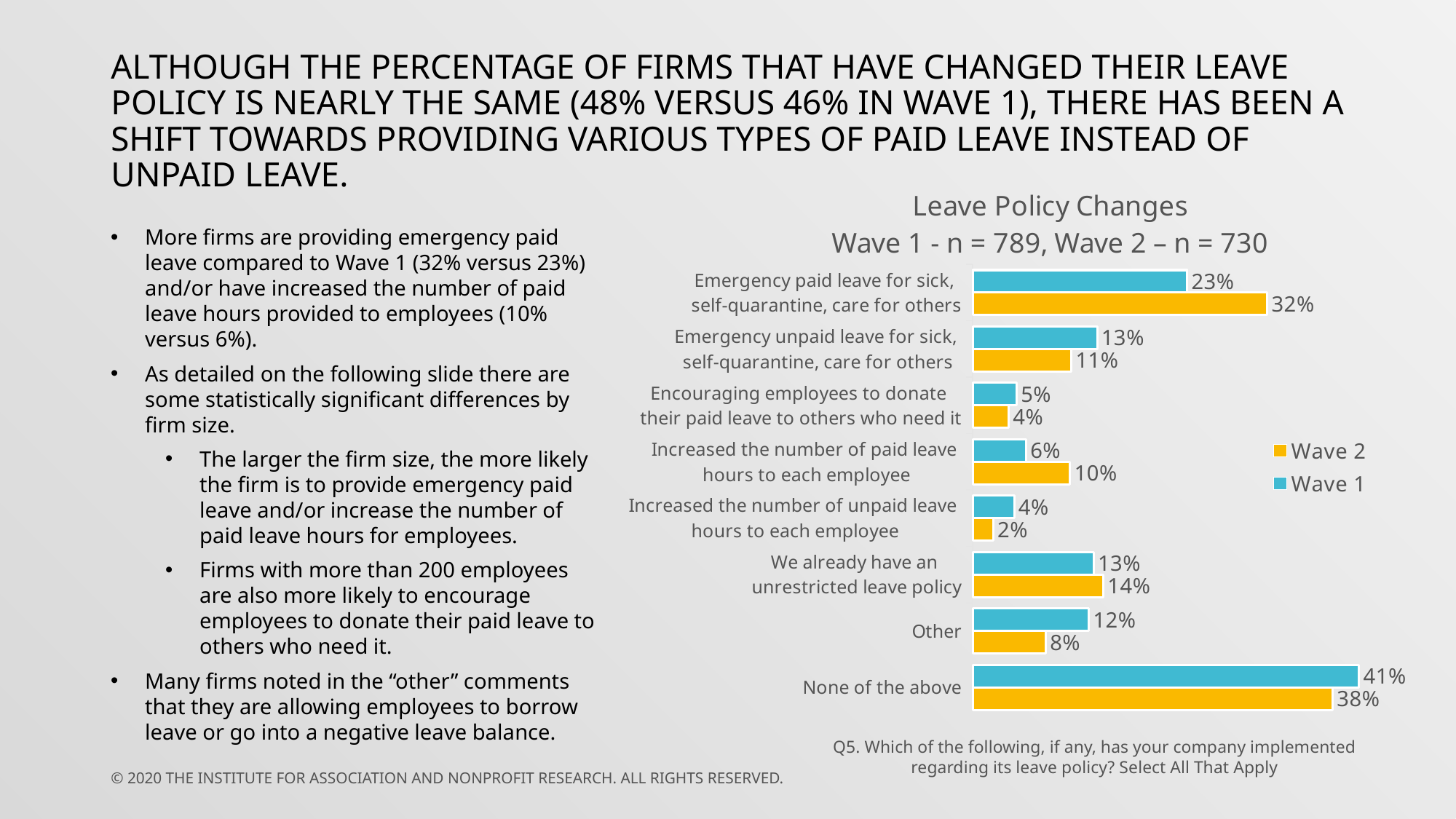
What is the Wave 1 value for "None of the above"? 41% Which is larger for "Increased the number of paid leave hours to each employee": Wave 1 or Wave 2? Wave 2 How many categories are shown in the chart? 8 Which category has the lowest Wave 2 value? Increased the number of unpaid leave hours to each employee Which category has the highest Wave 1 value? None of the above Which colour represents Wave 2 in the chart? Yellow What kind of chart is shown on the slide? Bar chart How many series does the legend list? 2 What is the title of the chart? Leave Policy Changes What is the difference between the Wave 2 and Wave 1 values for "Emergency paid leave for sick, self-quarantine, care for others"? 9% What is the Wave 2 value for "Other"? 8% What is the Wave 2 value for "Emergency paid leave for sick, self-quarantine, care for others"? 32%